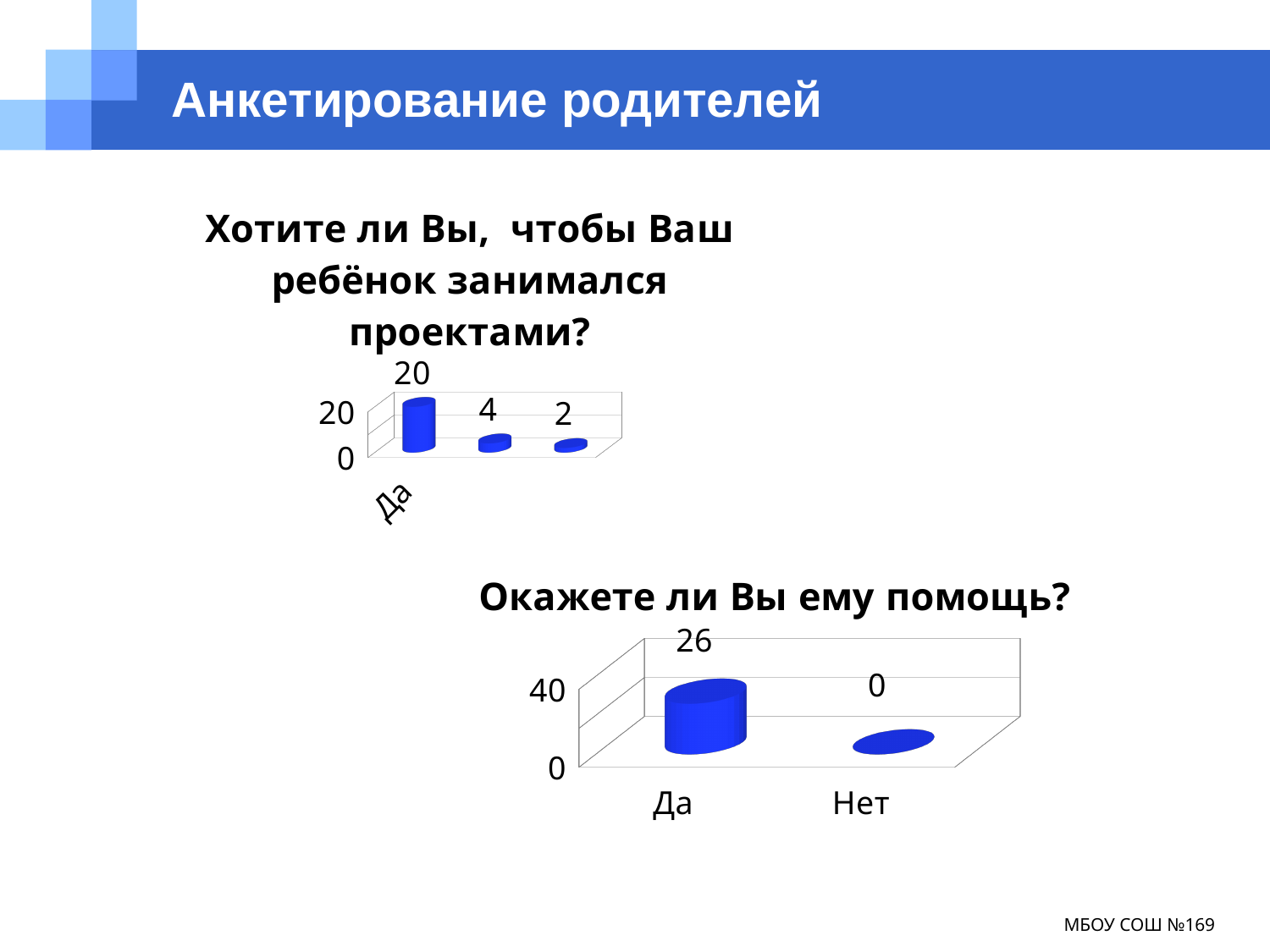
In the chart titled "Окажете ли Вы ему помощь?", what is the difference between the values for "Да" and "Нет"? 26 In the chart titled "Хотите ли Вы, чтобы Ваш ребёнок занимался проектами?", what is the difference between the first bar and the third bar? 18 In the chart titled "Окажете ли Вы ему помощь?", which category has the lowest value? Нет In the chart titled "Окажете ли Вы ему помощь?", what is the value for "Да"? 26 In the chart titled "Окажете ли Вы ему помощь?", is the value for "Да" greater or less than 40? less In the chart titled "Хотите ли Вы, чтобы Ваш ребёнок занимался проектами?", how many bars are plotted? 3 In the chart titled "Окажете ли Вы ему помощь?", what is the value for "Нет"? 0 In the chart titled "Хотите ли Вы, чтобы Ваш ребёнок занимался проектами?", do the values rise or fall from left to right? fall In the chart titled "Окажете ли Вы ему помощь?", how many categories are shown on the x axis? 2 In the chart titled "Хотите ли Вы, чтобы Ваш ребёнок занимался проектами?", what is the value for "Да"? 20 What kind of chart is the one titled "Окажете ли Вы ему помощь?"? bar chart In the chart titled "Окажете ли Вы ему помощь?", which category has the highest value? Да